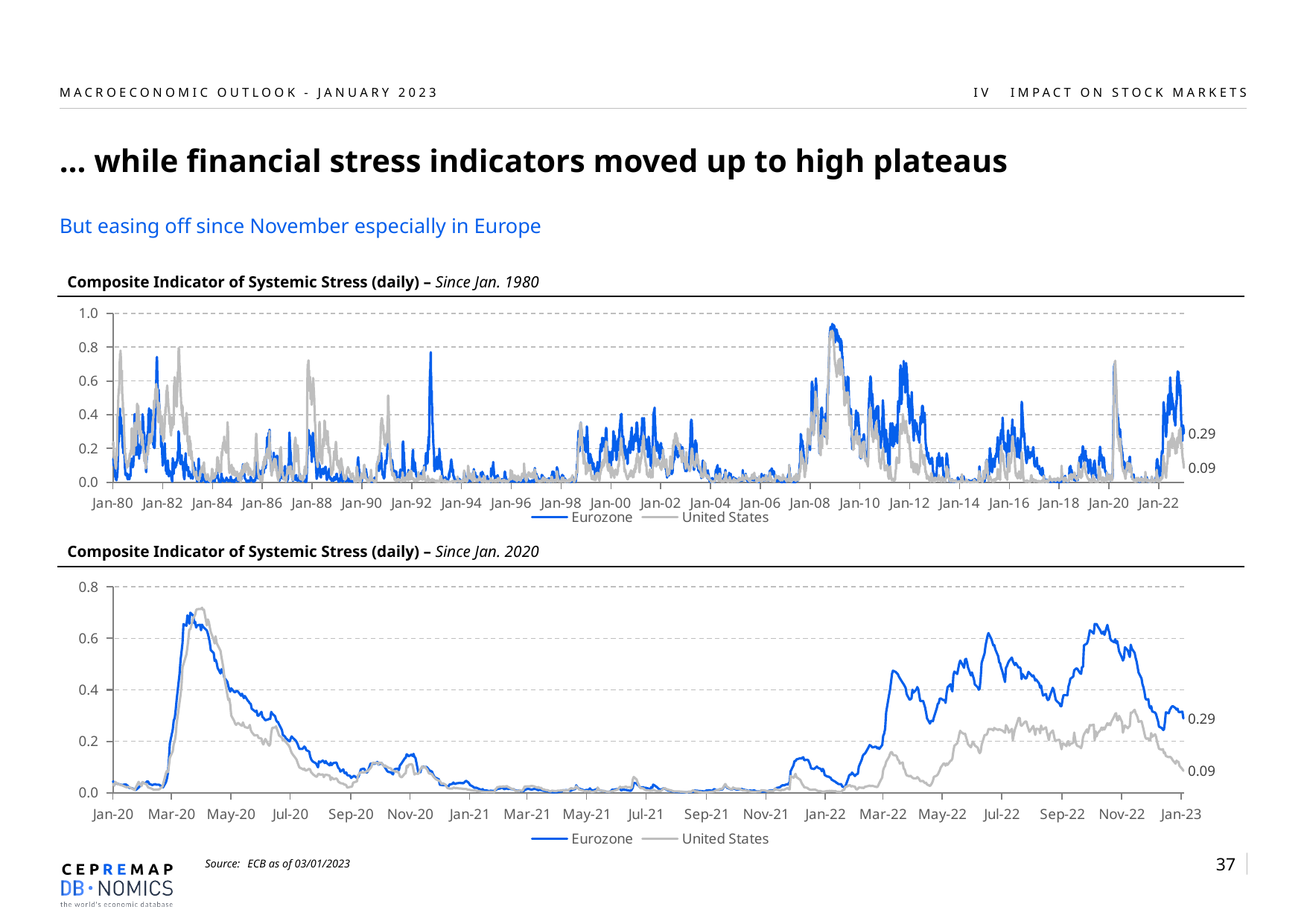
In the bottom chart (Since Jan. 2020), which series has the higher latest labelled value, Eurozone or United States? Eurozone In the bottom chart (Since Jan. 2020), does the Eurozone series rise or fall between Nov-22 and Jan-23? fall In the bottom chart (Since Jan. 2020), what is the difference between the latest labelled Eurozone value and the latest labelled United States value? 0.20 In the bottom chart (Since Jan. 2020), what is the latest labelled value for the Eurozone series? 0.29 In the bottom chart (Since Jan. 2020), is the Eurozone peak around Mar-20 greater or less than 0.6? greater In the top chart (Since Jan. 1980), what is the latest labelled value for the United States series? 0.09 In the bottom chart (Since Jan. 2020), what is the latest labelled value for the United States series? 0.09 What kind of chart is the bottom chart (Since Jan. 2020)? Line chart In the top chart (Since Jan. 1980), what is the latest labelled value for the Eurozone series? 0.29 What are the two legend entries shown under the bottom chart? Eurozone and United States How many series does the legend of the top chart (Since Jan. 1980) list? 2 In the top chart (Since Jan. 1980), is the Eurozone peak around Jan-08 to Jan-10 greater or less than 0.8? greater